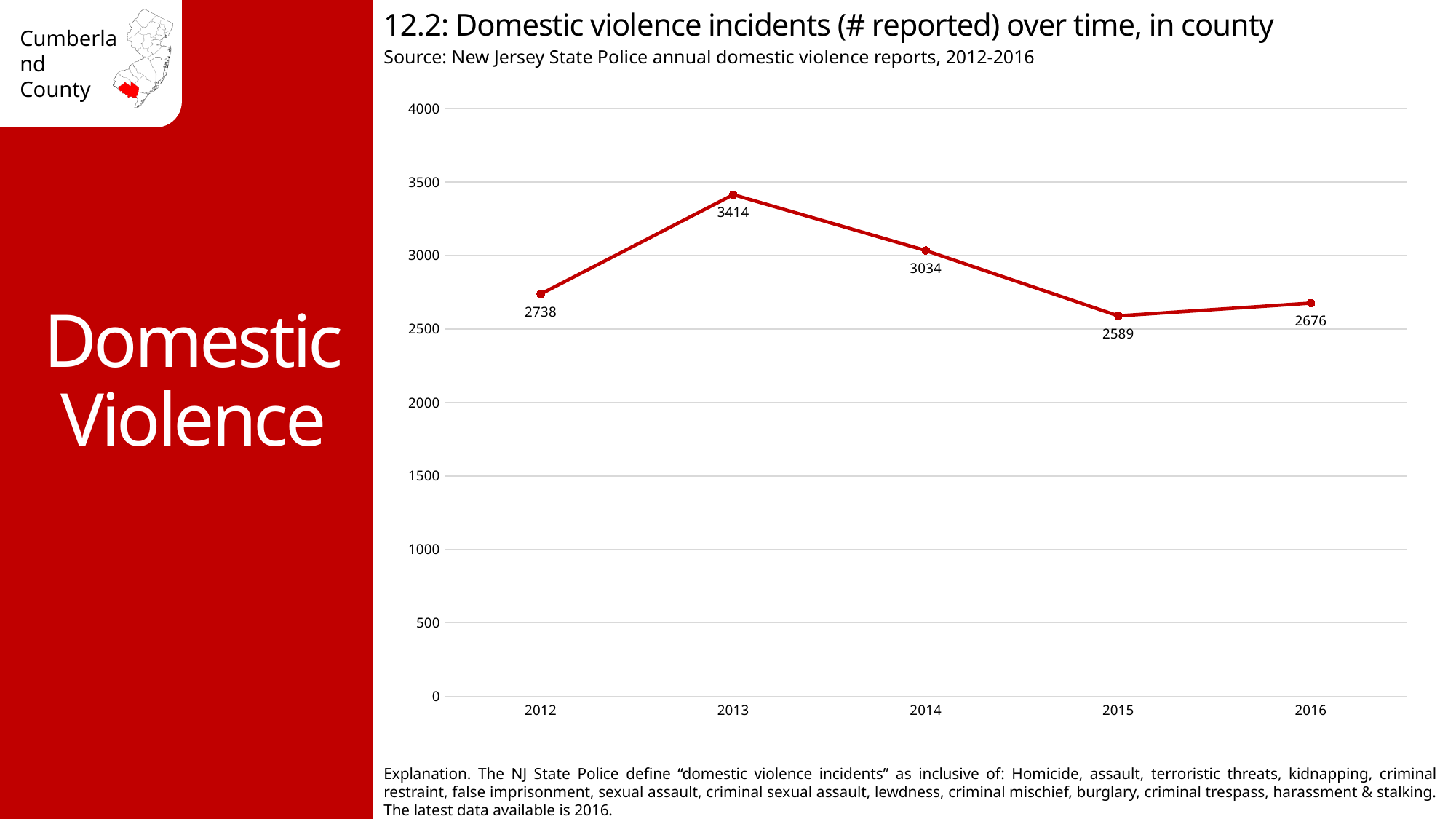
What is the value for 2015? 2589 What is the difference between the 2013 and 2014 values? 380 Is the value for 2014 greater or less than 3000? greater Do the values rise or fall from 2013 to 2015? fall Which year has the highest number of reported incidents? 2013 Which year has a larger value, 2012 or 2016? 2012 How many domestic violence incidents were reported in 2013? 3414 How many years are plotted on the chart? 5 Which year has the lowest number of reported incidents? 2015 What is the value for 2012? 2738 What is the difference between the 2016 and 2015 values? 87 What kind of chart is shown? line chart